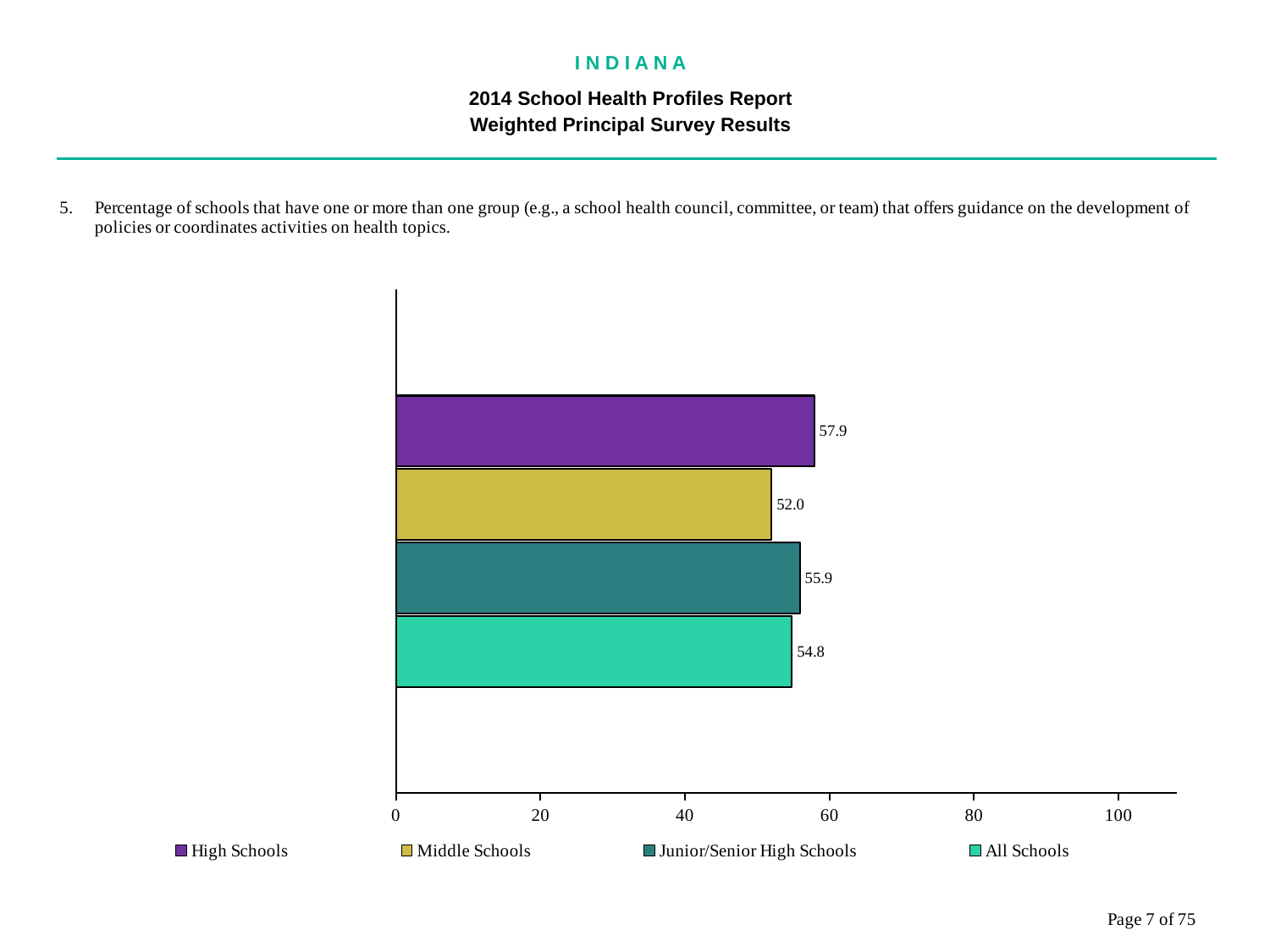
Is the value for Middle Schools greater or less than 60? less What is the difference between the values for High Schools and Middle Schools? 5.9 Which is larger, the value for Junior/Senior High Schools or the value for All Schools? Junior/Senior High Schools What is the value for All Schools? 54.8 What kind of chart is shown on the slide? bar chart What is the value for Junior/Senior High Schools? 55.9 How many entries does the legend list? 4 What is the value for Middle Schools? 52.0 How many bars are shown in the chart? 4 Which school type has the highest value? High Schools Which school type has the lowest value? Middle Schools What is the value for High Schools? 57.9